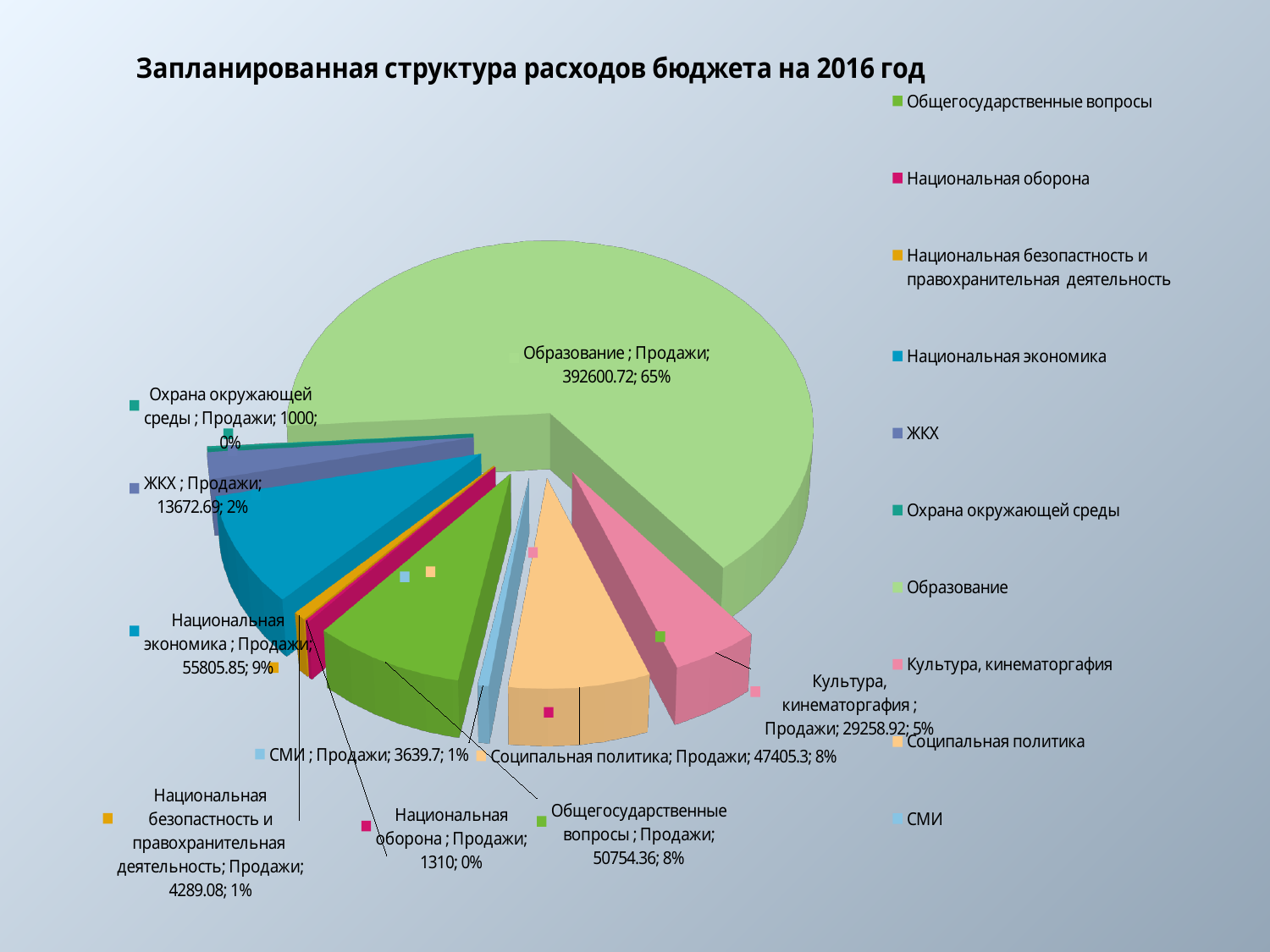
What is the value shown for Культура, кинематоргафия? 29258.92 What share of the pie does Соципальная политика represent? 8% What is the value shown for Образование? 392600.72 Which category has the largest slice of the pie? Образование Which is larger, the value for Национальная экономика or the value for Соципальная политика? Национальная экономика What is the title of the chart? Запланированная структура расходов бюджета на 2016 год What share of the pie does Образование represent? 65% What type of chart is shown on the slide? Pie chart What is the value shown for Национальная экономика? 55805.85 Which category has the smallest value in the chart? Охрана окружающей среды How many categories does the legend list? 10 What is the difference between the values for Общегосударственные вопросы and Соципальная политика? 3349.06